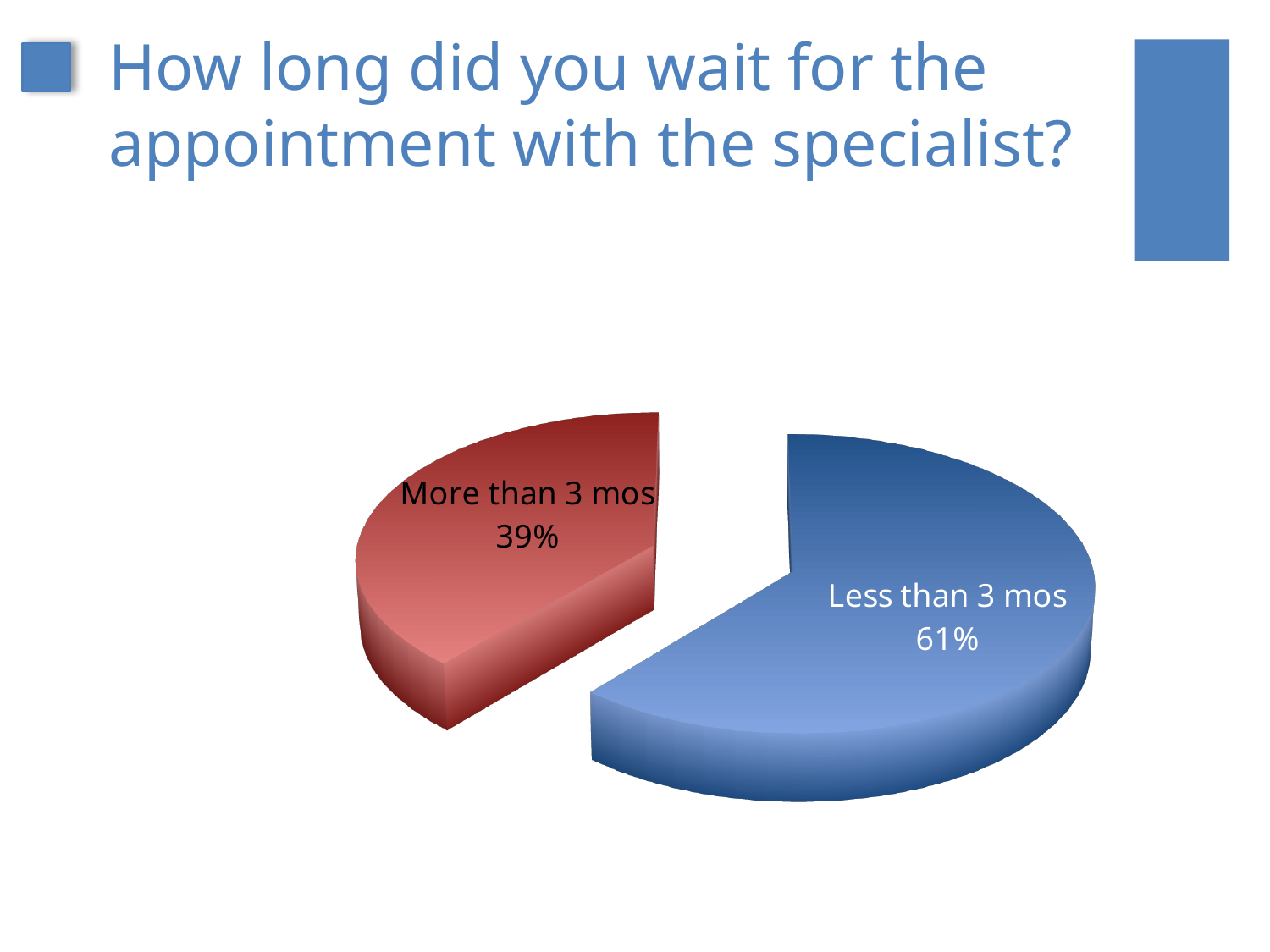
How many slices does the pie chart have? 2 What is the title of the slide containing the pie chart? How long did you wait for the appointment with the specialist? What colour is the "More than 3 mos" slice? red What is the difference in percentage points between the "Less than 3 mos" and "More than 3 mos" slices? 22 Which slice is larger, "Less than 3 mos" or "More than 3 mos"? Less than 3 mos What share of the pie is labelled "More than 3 mos"? 39% What share of the pie is labelled "Less than 3 mos"? 61% Which slice of the pie is the largest? Less than 3 mos Which slice of the pie is the smallest? More than 3 mos What type of chart is shown on the slide? pie chart Is the share for "More than 3 mos" greater or less than 50%? less